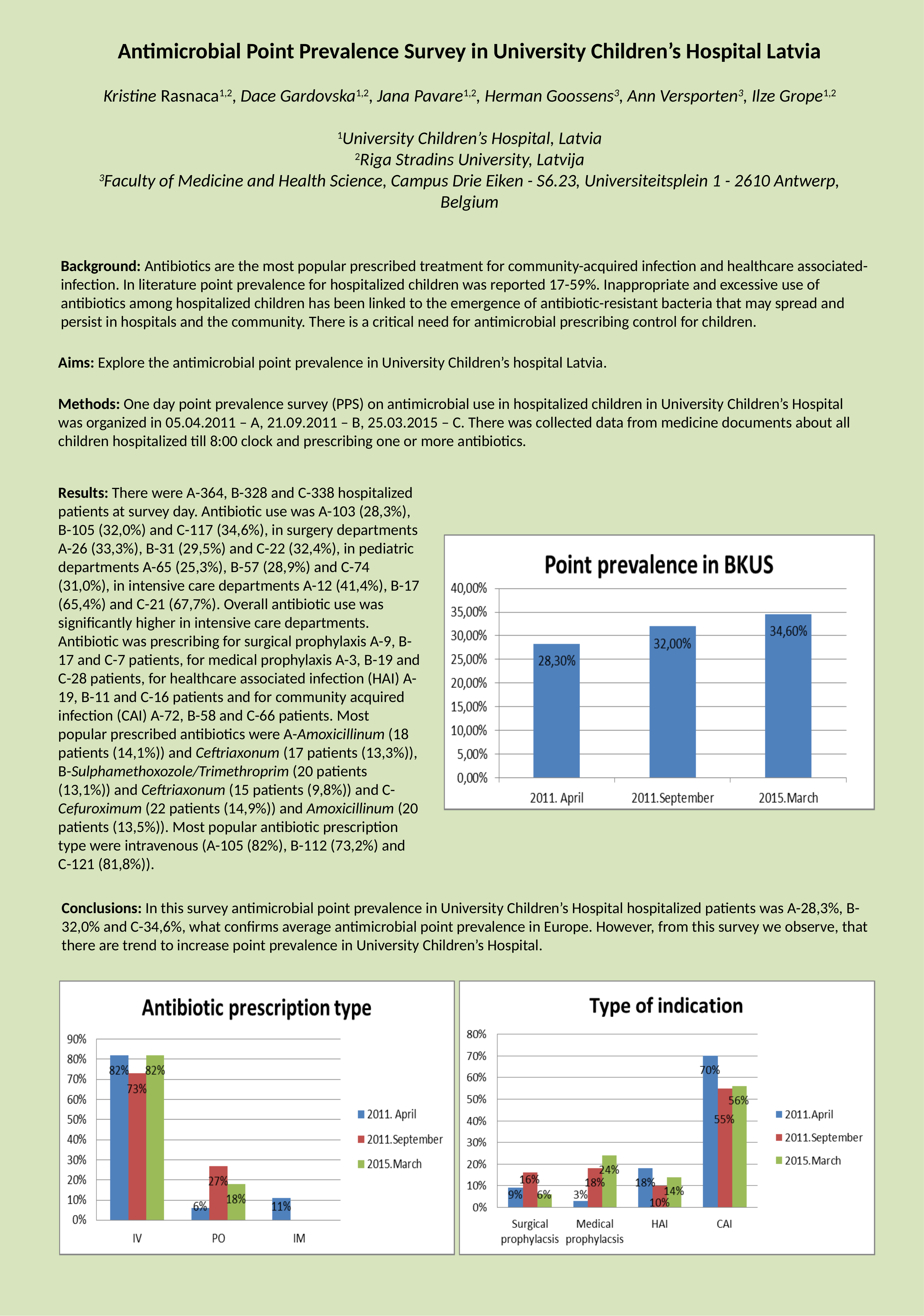
In the 'Type of indication' chart, what is the value for CAI in 2011.April? 70% In the 'Antibiotic prescription type' chart, what is the value for IV in 2011.September? 73% In the 'Point prevalence in BKUS' chart, do the values rise or fall from 2011. April to 2015.March? rise In the 'Point prevalence in BKUS' chart, what is the value for 2015.March? 34,60% In the 'Antibiotic prescription type' chart, how many series does the legend list? 3 In the 'Point prevalence in BKUS' chart, how many bars are plotted? 3 In the 'Type of indication' chart, which category has the highest value in 2015.March? CAI What kind of chart is 'Type of indication'? bar chart In the 'Antibiotic prescription type' chart, what is the value for PO in 2011.September? 27% In the 'Point prevalence in BKUS' chart, what is the value for 2011. April? 28,30% In the 'Antibiotic prescription type' chart, what is the difference between the 2011. April and 2011.September values for IV? 9% In the 'Type of indication' chart, which is larger for Medical prophylacsis: 2011.September or 2015.March? 2015.March